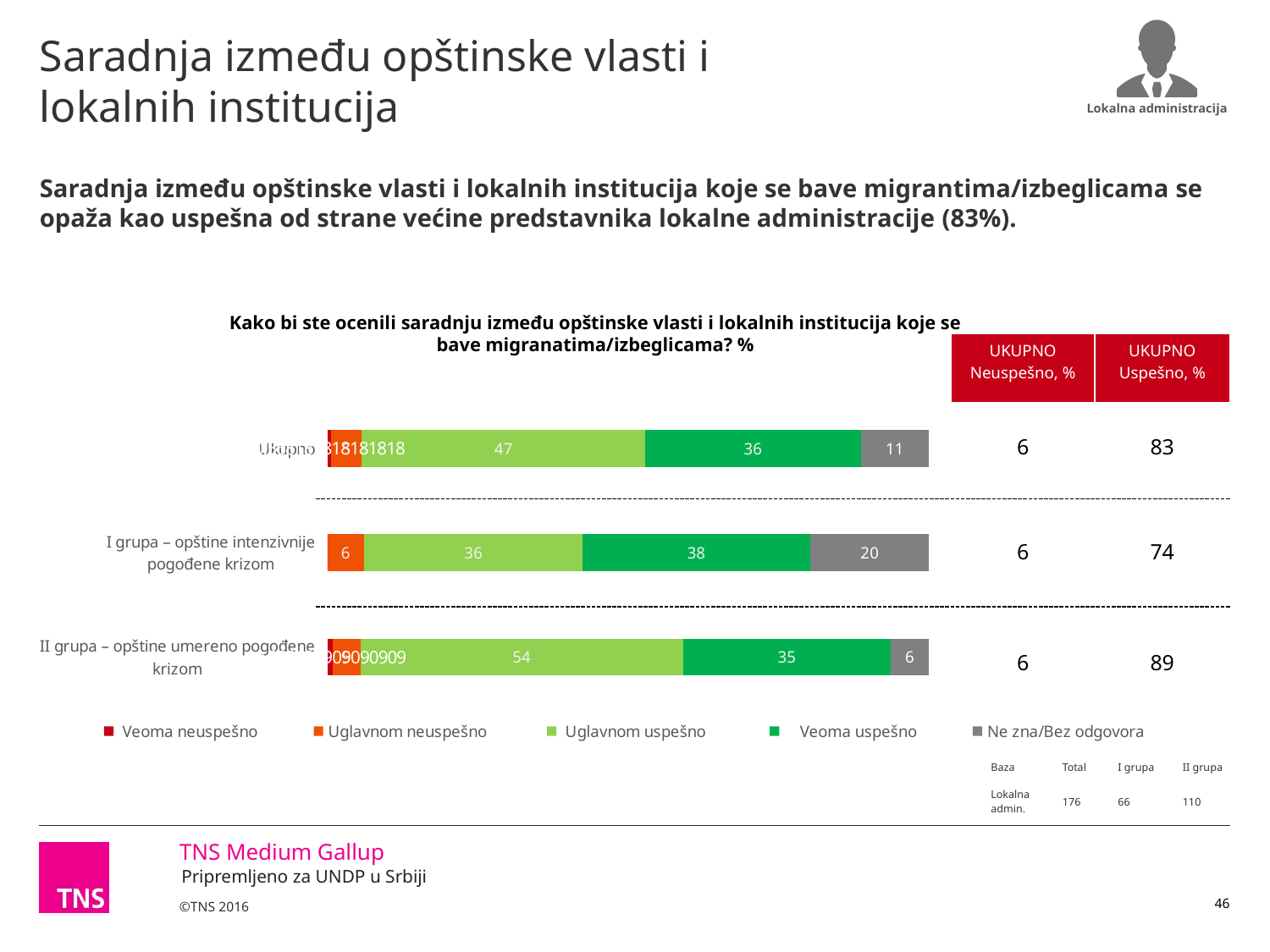
According to the 'UKUPNO Uspešno, %' column, what is the value for 'II grupa'? 89 How many series does the chart legend list? 5 What is the value for 'Veoma uspešno' in the 'I grupa – opštine intenzivnije pogođene krizom' row? 38 Which row has the lowest 'Ne zna/Bez odgovora' value? II grupa – opštine umereno pogođene krizom What is the value for 'Ne zna/Bez odgovora' in the 'II grupa – opštine umereno pogođene krizom' row? 6 Is the 'Uglavnom uspešno' value larger for 'Ukupno' or for 'I grupa'? Ukupno Which row has the highest 'Uglavnom uspešno' value? II grupa – opštine umereno pogođene krizom What type of chart is shown on the slide? Stacked bar chart What is the difference between the 'Ne zna/Bez odgovora' values for 'I grupa' and 'Ukupno'? 9 What is the value for 'Uglavnom uspešno' in the 'Ukupno' row? 47 How many categories (rows) are plotted in the chart? 3 What is the value for 'Uglavnom neuspešno' in the 'I grupa' row? 6